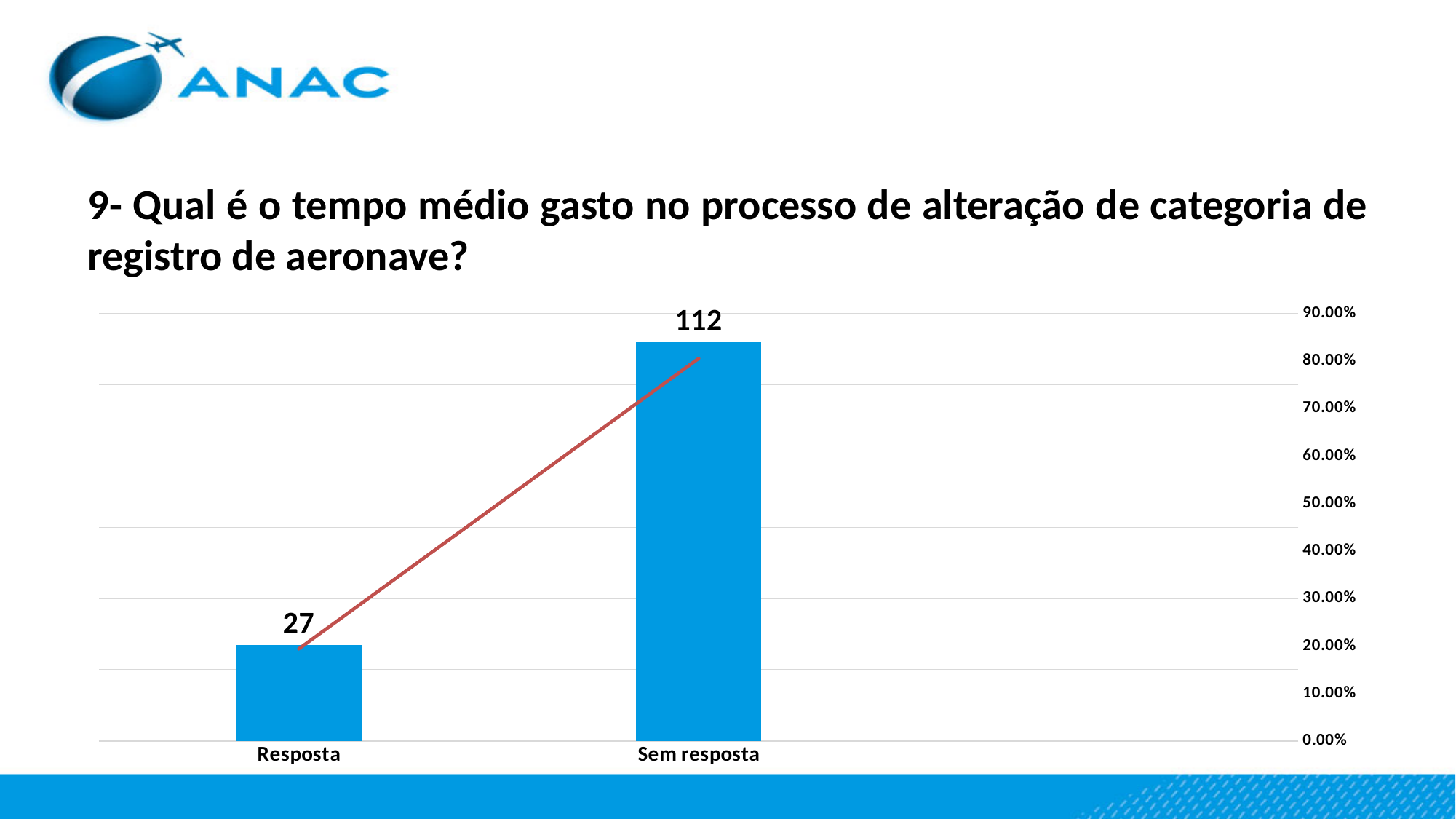
What is the data label shown on the bar for "Resposta"? 27 Which is larger, the value for "Resposta" or the value for "Sem resposta"? Sem resposta Which category has the highest bar? Sem resposta What is the highest tick label shown on the percentage axis on the right of the chart? 90.00% What is the difference between the labelled values for "Sem resposta" and "Resposta"? 85 Which category has the lowest bar? Resposta On the percentage axis, is the bar for "Resposta" greater or less than 30.00%? less How many categories are shown on the x axis of the chart? 2 Do the bar values rise or fall from "Resposta" to "Sem resposta"? Rise What kind of chart is shown on the slide? Combination bar and line chart What is the data label shown on the bar for "Sem resposta"? 112 On the percentage axis, is the bar for "Sem resposta" greater or less than 70.00%? greater